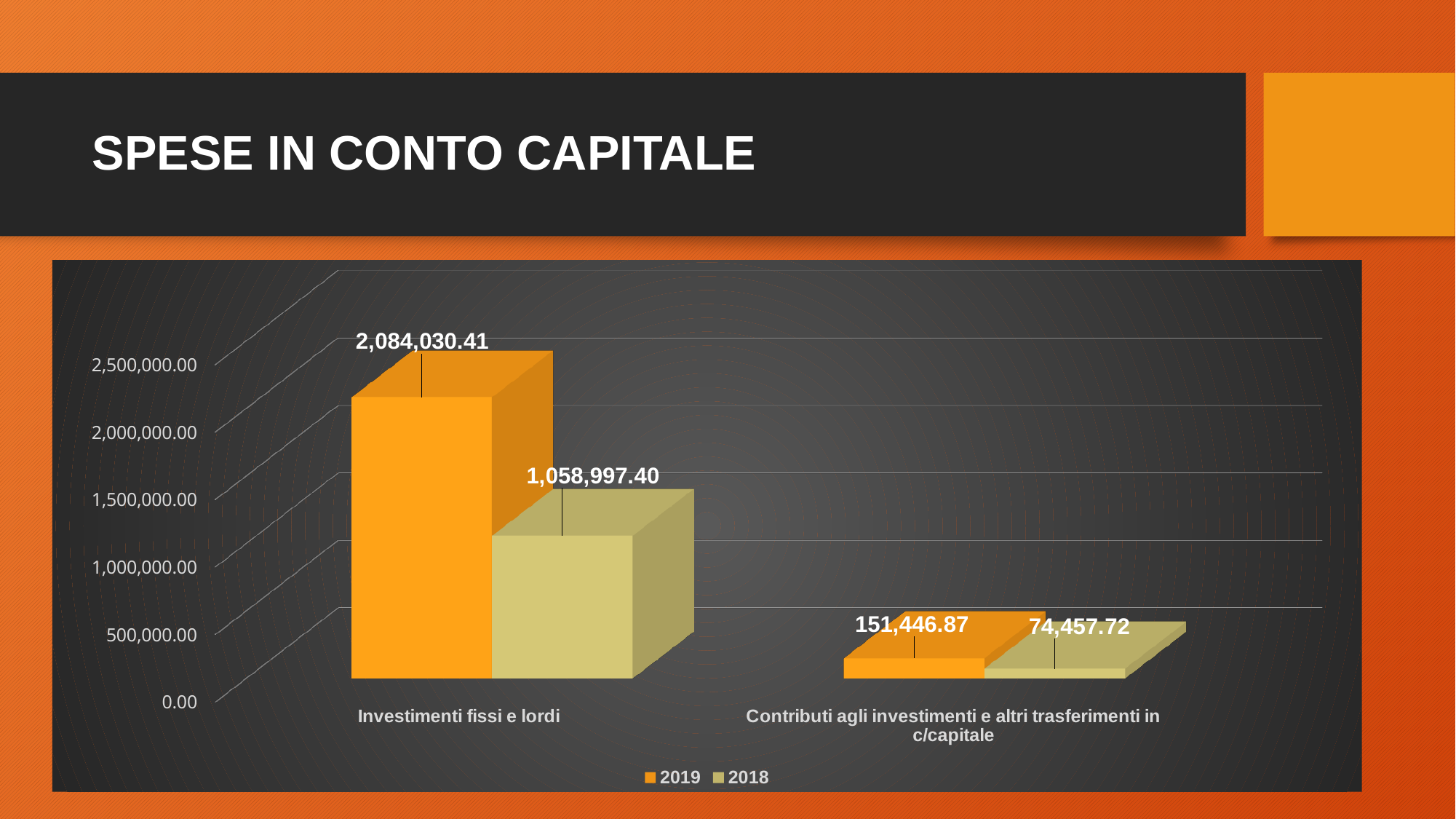
What is the difference between the 2019 and 2018 values for Contributi agli investimenti e altri trasferimenti in c/capitale? 76,989.15 How many categories are shown on the x axis? 2 Which is larger for Investimenti fissi e lordi, the 2019 value or the 2018 value? 2019 What is the 2019 value for Contributi agli investimenti e altri trasferimenti in c/capitale? 151,446.87 What is the 2018 value for Contributi agli investimenti e altri trasferimenti in c/capitale? 74,457.72 What is the 2018 value for Investimenti fissi e lordi? 1,058,997.40 What kind of chart is shown on the slide? Bar chart How many series does the legend list? 2 Which category has the highest 2019 value? Investimenti fissi e lordi What is the 2019 value for Investimenti fissi e lordi? 2,084,030.41 What is the difference between the 2019 and 2018 values for Investimenti fissi e lordi? 1,025,033.01 Which category has the lowest 2018 value? Contributi agli investimenti e altri trasferimenti in c/capitale